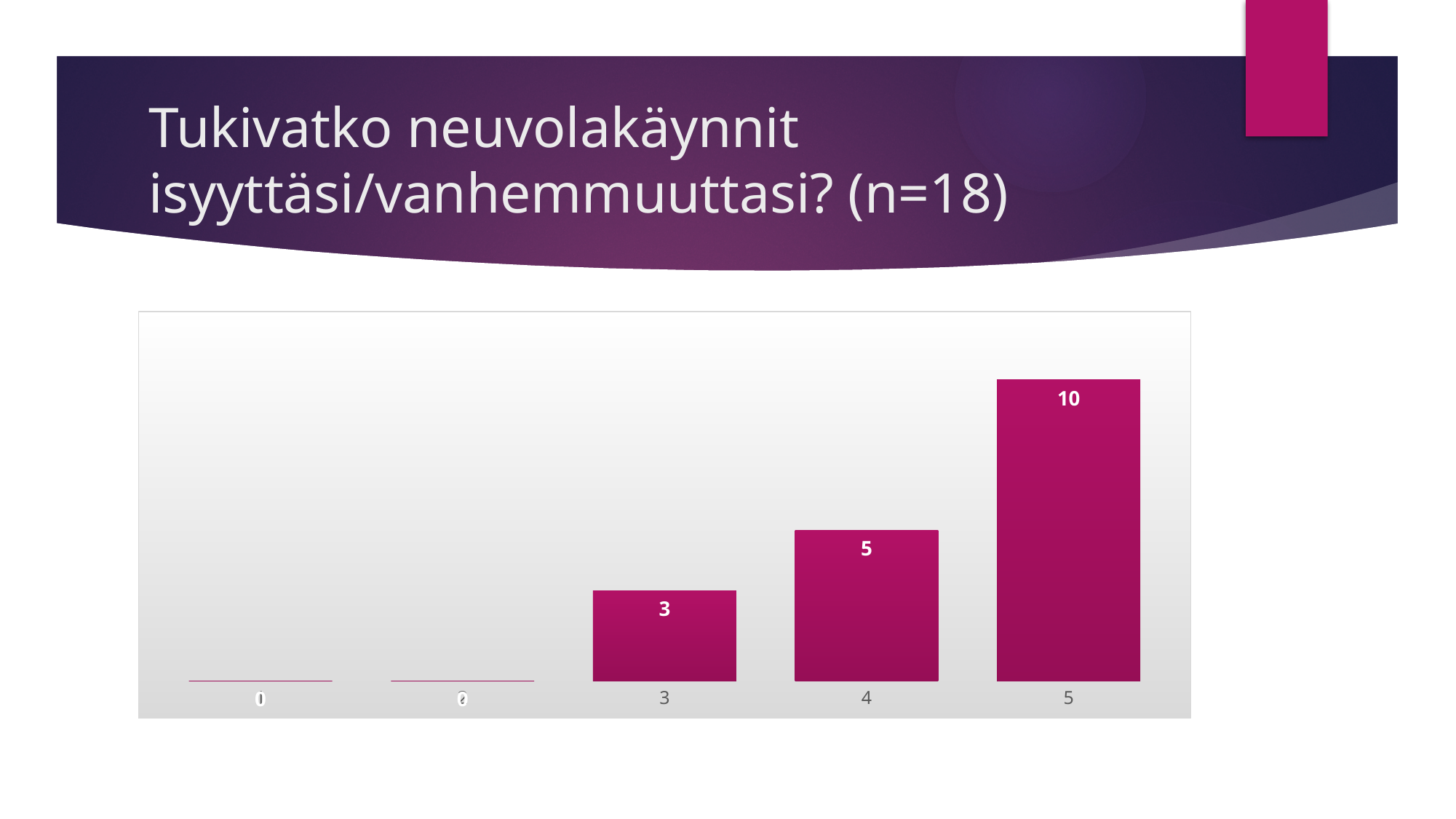
What is the sum of the values for categories 3, 4 and 5? 18 What is the value for category 4? 5 What is the difference between the values for category 5 and category 4? 5 What kind of chart is shown on the slide? bar chart What is the value for category 5? 10 What is the difference between the values for category 5 and category 3? 7 Do the values rise or fall from category 3 to category 5? rise Which category has the highest value? 5 Which is larger, the value for category 4 or category 3? category 4 Among categories 3, 4 and 5, which has the lowest value? 3 What is the title of the slide containing the chart? Tukivatko neuvolakäynnit isyyttäsi/vanhemmuuttasi? (n=18) What is the value for category 3? 3